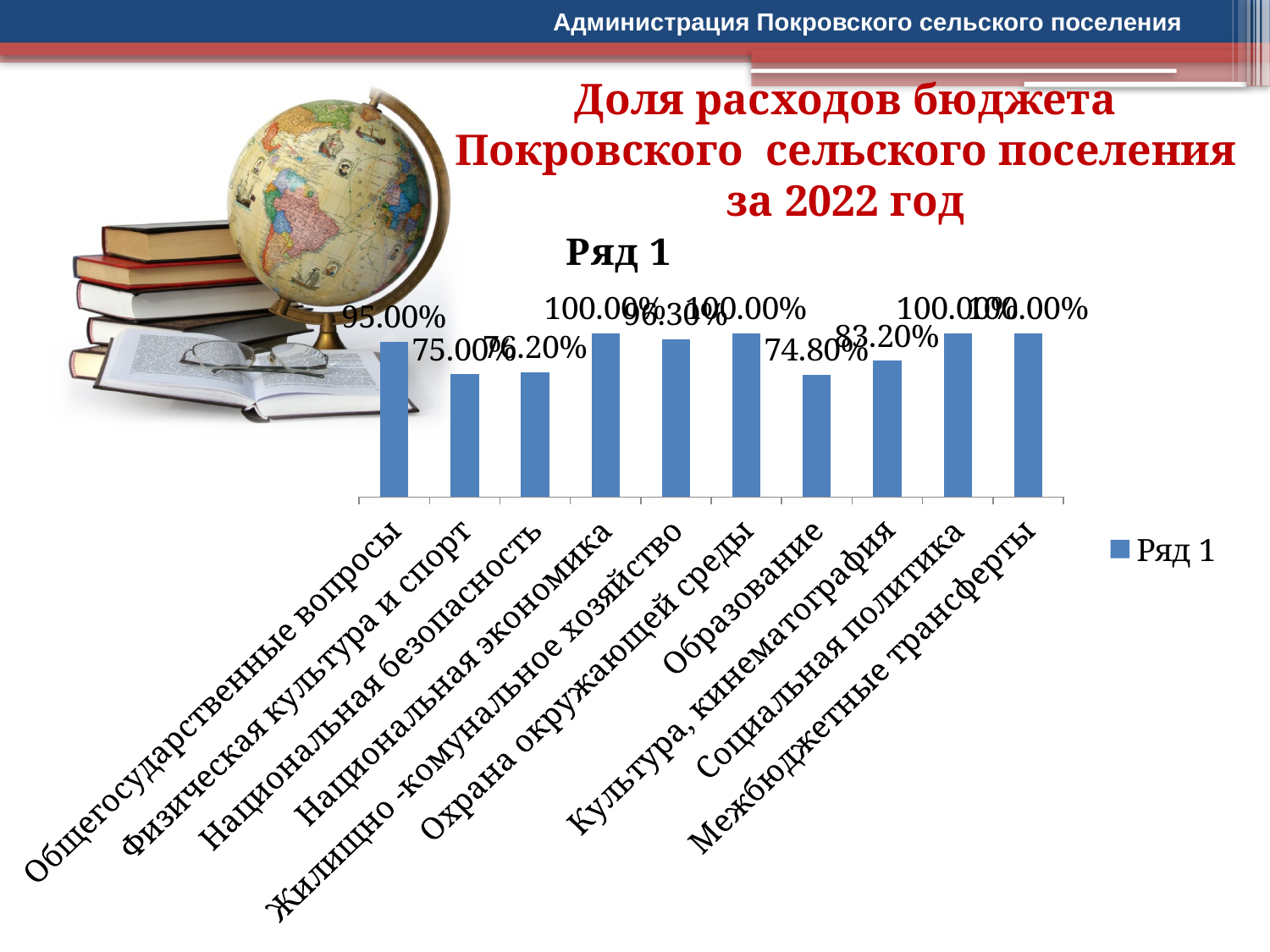
What is the value for Культура, кинематография? 83.20% How many series does the legend list? 1 What is the difference between the values for Общегосударственные вопросы and Физическая культура и спорт? 20.00% How many categories are shown on the x axis of the chart? 10 Which category has the lowest value? Образование What is the value for Физическая культура и спорт? 75.00% What is the value for Общегосударственные вопросы? 95.00% Which is larger, the value for Национальная безопасность or the value for Культура, кинематография? Культура, кинематография What is the name of the series shown in the legend? Ряд 1 What is the value for Образование? 74.80% How many categories have a value of 100.00%? 4 What type of chart is shown on the slide? bar chart